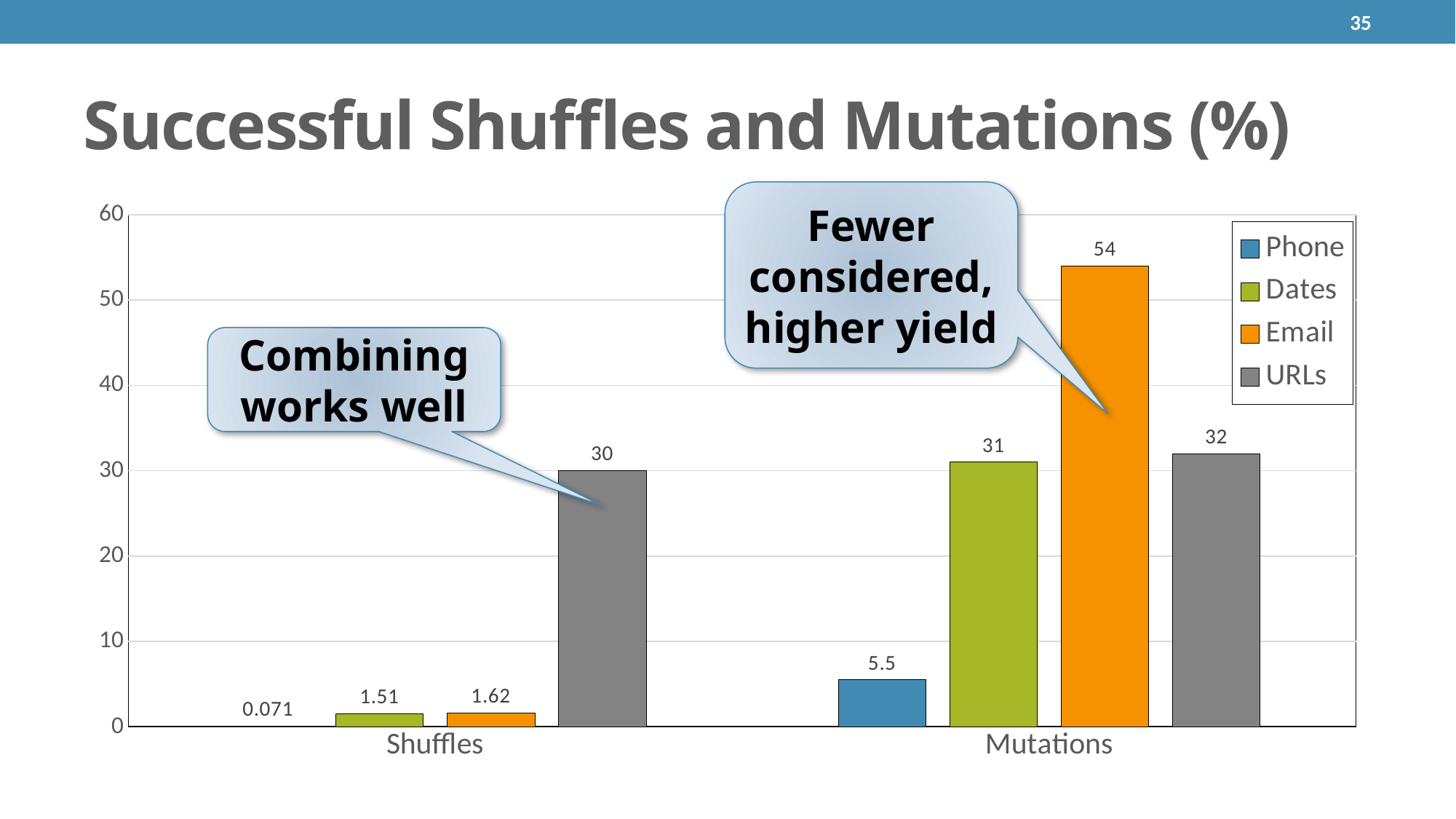
What is the title of the slide? Successful Shuffles and Mutations (%) What is the value for Phone in the Shuffles category? 0.071 What is the value for URLs in the Shuffles category? 30 What is the difference between the Email value for Mutations and the Email value for Shuffles? 52.38 What kind of chart is shown on the slide? Bar chart What is the value for Email in the Mutations category? 54 What is the value for Dates in the Mutations category? 31 How many series does the legend list? 4 Which is larger: the URLs value for Mutations or the Dates value for Mutations? URLs Which series has the highest value in the Mutations category? Email Which series has the lowest value in the Shuffles category? Phone How many categories are shown on the x axis? 2